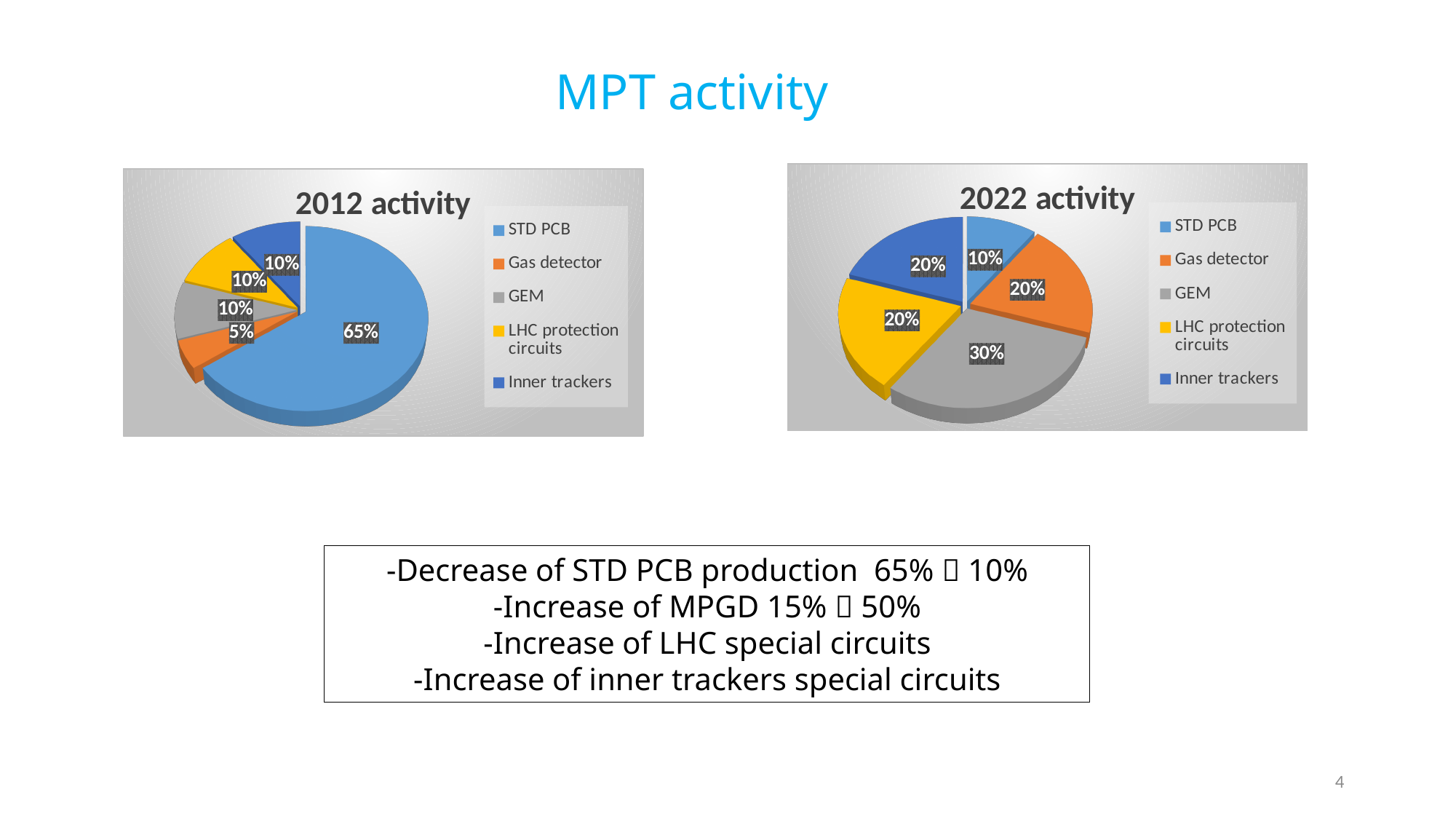
In the "2012 activity" chart, what share does STD PCB have? 65% In the "2022 activity" chart, which category has the largest slice? GEM In the "2012 activity" chart, which category has the smallest slice? Gas detector How many categories does the legend of the "2022 activity" chart list? 5 What type of chart is the "2012 activity" chart? Pie chart In the "2012 activity" chart, which category has the largest slice? STD PCB In the "2012 activity" chart, what share does Gas detector have? 5% What is the difference between the STD PCB share in the "2012 activity" chart and in the "2022 activity" chart? 55% In the "2022 activity" chart, what share does STD PCB have? 10% In the "2022 activity" chart, which is larger: the GEM slice or the Gas detector slice? GEM In the "2022 activity" chart, which category has the smallest slice? STD PCB In the "2022 activity" chart, what share does GEM have? 30%